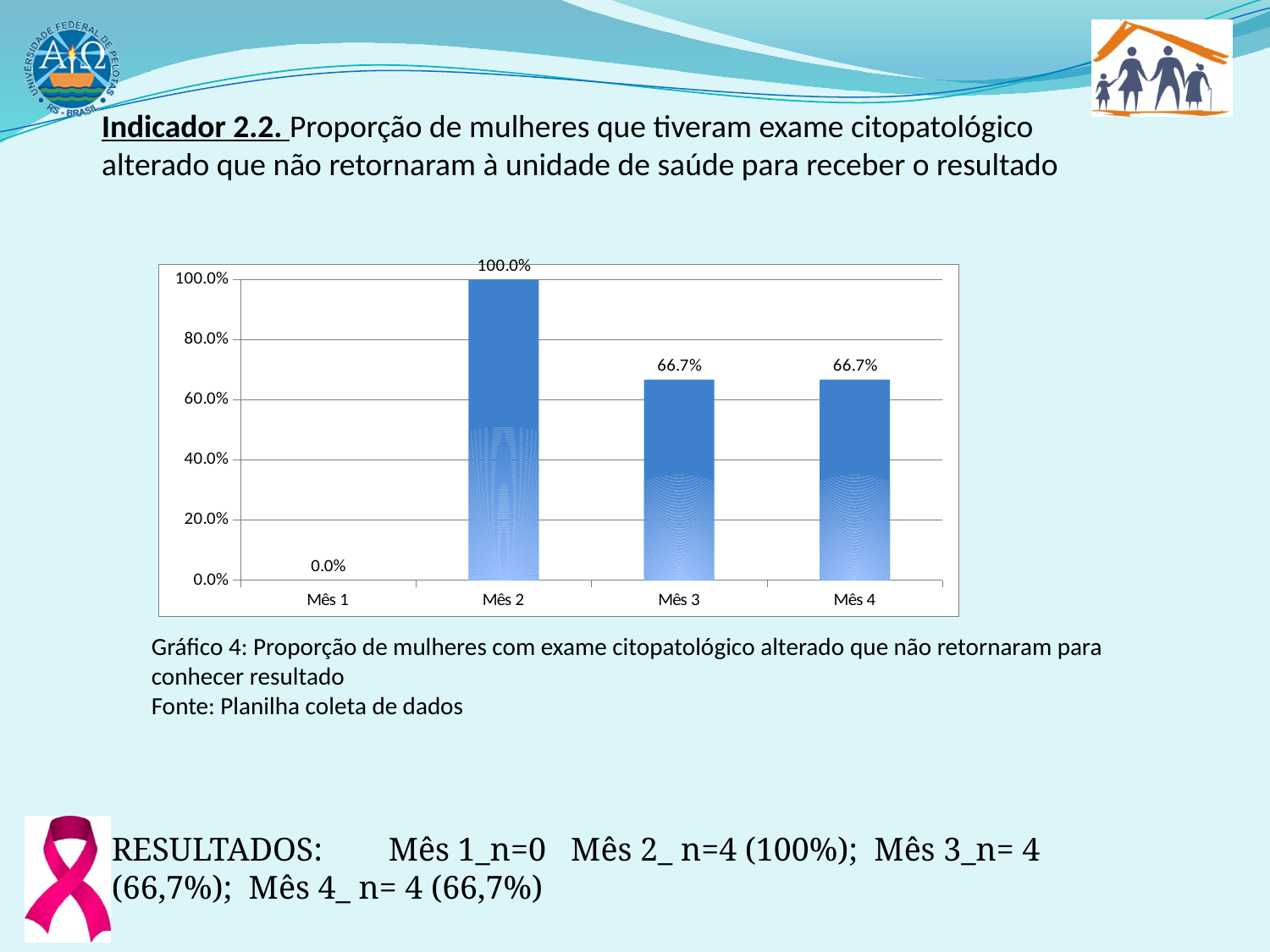
Which month has the lowest value? Mês 1 What is the highest value shown on the y axis? 100.0% Do the values rise or fall from Mês 2 to Mês 3? fall Which month has the highest value? Mês 2 What is the value for Mês 2? 100.0% What kind of chart is shown on the slide? bar chart What is the difference between the values for Mês 2 and Mês 3? 33.3% What is the value for Mês 1? 0.0% Is the value for Mês 3 greater or less than 80.0%? less How many months are shown on the x axis? 4 What is the value for Mês 3? 66.7% Which is larger, the value for Mês 2 or the value for Mês 4? Mês 2